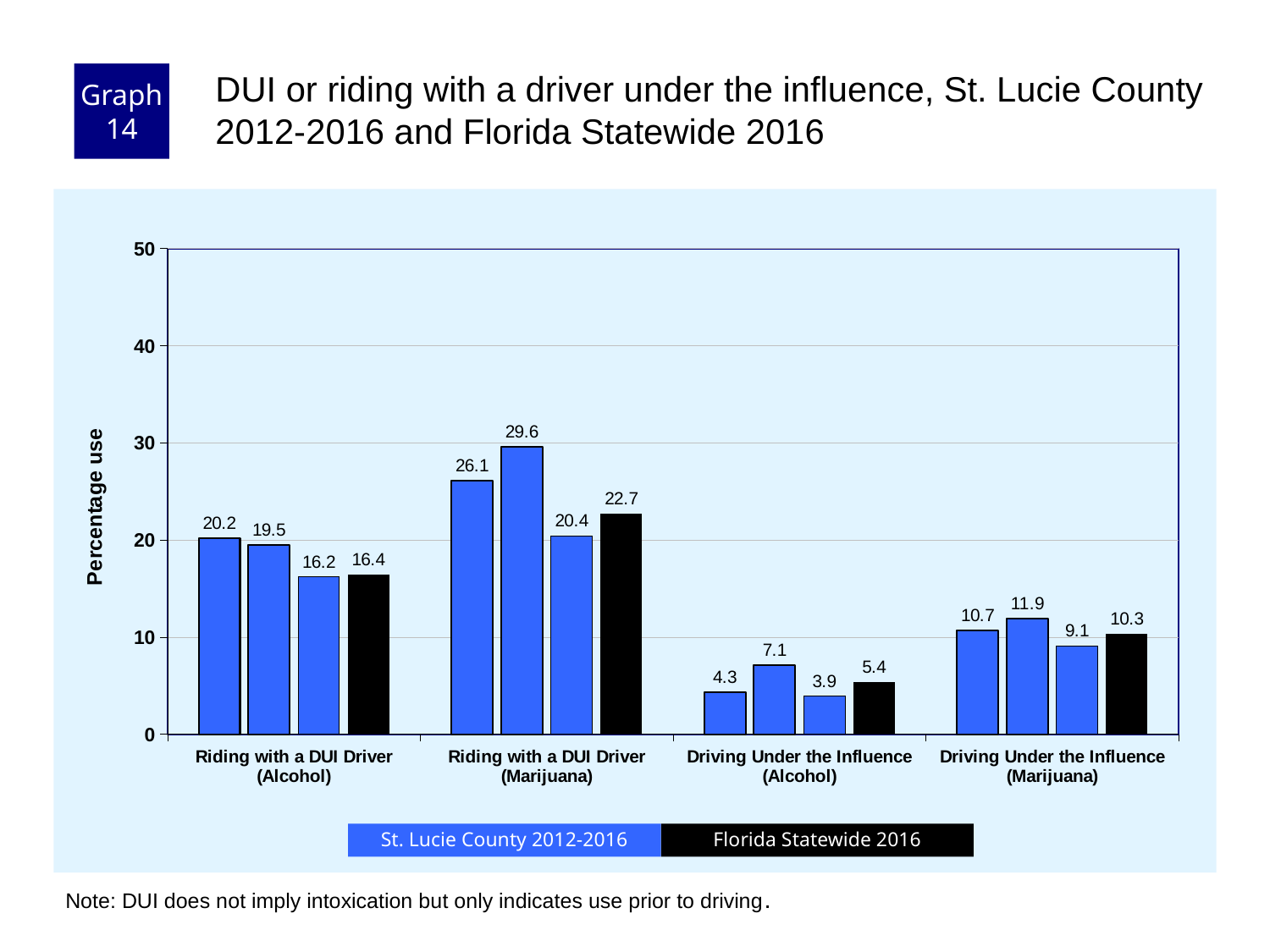
What is the value of the shortest bar in the Driving Under the Influence (Alcohol) group? 3.9 What is the Florida Statewide 2016 value for Driving Under the Influence (Marijuana)? 10.3 How many category groups are shown on the x axis? 4 What kind of chart is shown on the slide? bar chart What colour are the Florida Statewide 2016 bars? black What is the Florida Statewide 2016 value for Riding with a DUI Driver (Alcohol)? 16.4 What is the value of the tallest bar in the Riding with a DUI Driver (Marijuana) group? 29.6 Which is larger: the Florida Statewide 2016 value for Driving Under the Influence (Alcohol) or the Florida Statewide 2016 value for Driving Under the Influence (Marijuana)? Driving Under the Influence (Marijuana) Is the Florida Statewide 2016 value for Riding with a DUI Driver (Marijuana) greater or less than 20? greater What is the difference between the Florida Statewide 2016 value for Riding with a DUI Driver (Marijuana) and the Florida Statewide 2016 value for Riding with a DUI Driver (Alcohol)? 6.3 What is the label of the y axis? Percentage use How many series does the legend list? 2